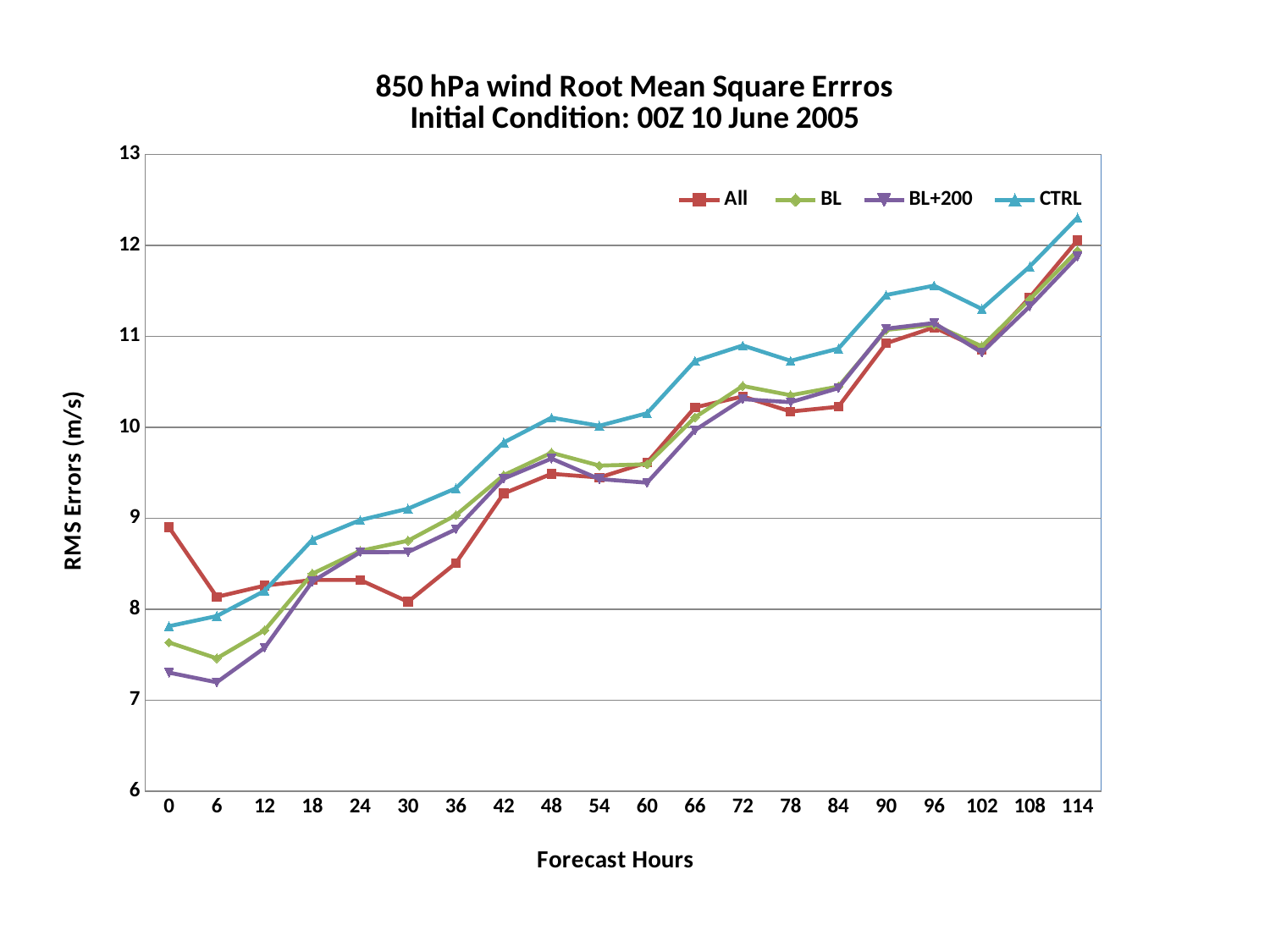
What kind of chart is shown on the slide? line chart Is the BL+200 value at forecast hour 6 greater or less than 8? less At forecast hour 0, which is larger: the All value or the BL+200 value? All Is the BL value at forecast hour 48 greater or less than 10? less Do the CTRL values generally rise or fall as forecast hours increase? rise What is the label of the y axis? RMS Errors (m/s) How many series does the legend list? 4 How many forecast hour points are plotted along the x axis? 20 Is the CTRL value at forecast hour 114 greater or less than 12? greater Which series has the lowest value at forecast hour 6? BL+200 Which series has the highest value at forecast hour 60? CTRL